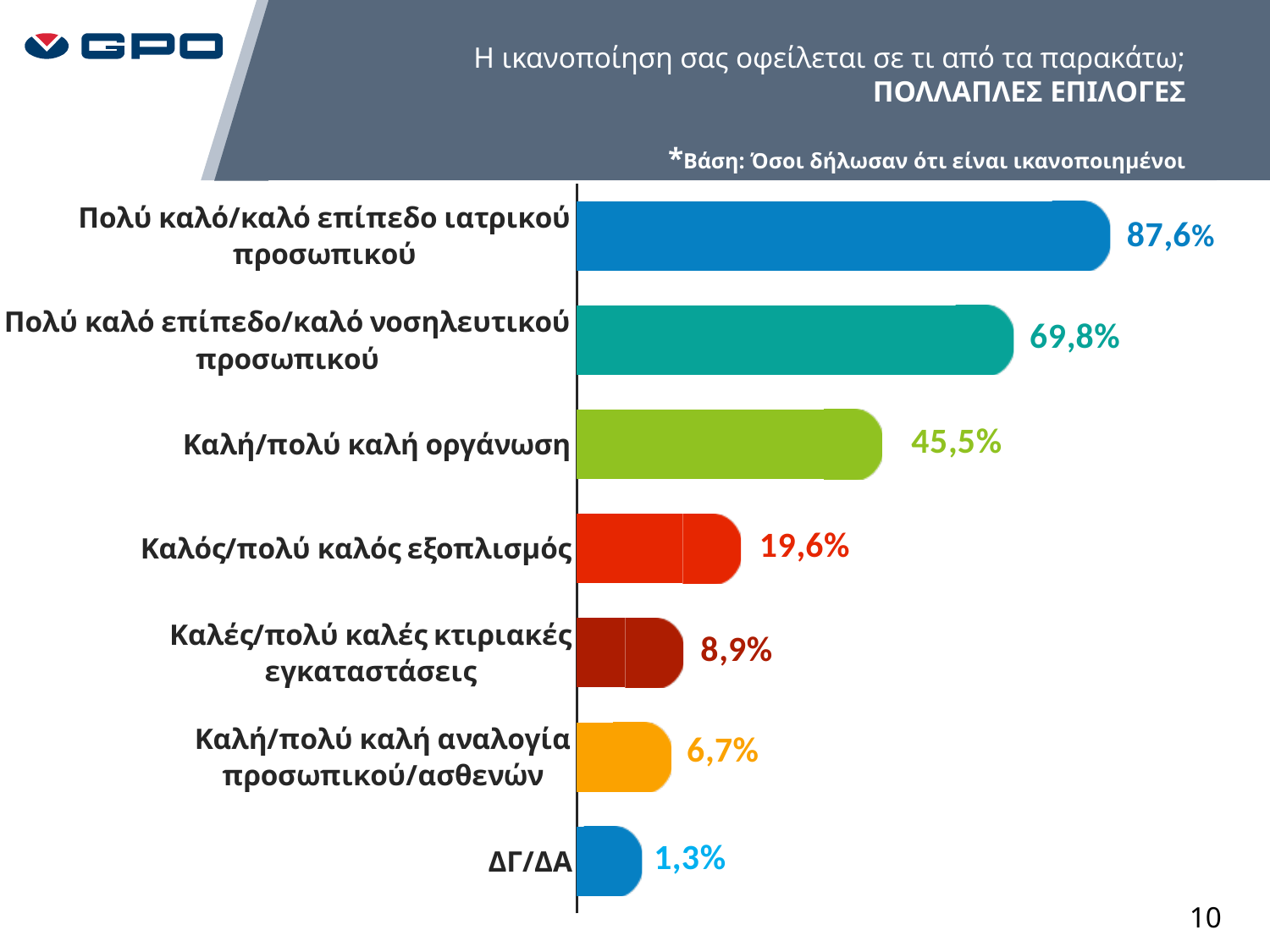
What is the value for 'Πολύ καλό/καλό επίπεδο ιατρικού προσωπικού'? 87,6% Which category has the lowest value? ΔΓ/ΔΑ How many categories are shown in the chart? 7 What is the difference between the values for 'Πολύ καλό/καλό επίπεδο ιατρικού προσωπικού' and 'Πολύ καλό επίπεδο/καλό νοσηλευτικού προσωπικού'? 17,8% Which is larger: the value for 'Καλές/πολύ καλές κτιριακές εγκαταστάσεις' or 'Καλή/πολύ καλή αναλογία προσωπικού/ασθενών'? Καλές/πολύ καλές κτιριακές εγκαταστάσεις What is the value for 'Καλή/πολύ καλή οργάνωση'? 45,5% What is the value for 'Καλός/πολύ καλός εξοπλισμός'? 19,6% What is the difference between the values for 'Καλός/πολύ καλός εξοπλισμός' and 'Καλές/πολύ καλές κτιριακές εγκαταστάσεις'? 10,7% What is the value for 'ΔΓ/ΔΑ'? 1,3% What kind of chart is shown on the slide? Bar chart Which category has the highest value? Πολύ καλό/καλό επίπεδο ιατρικού προσωπικού What colour is the bar for 'Καλή/πολύ καλή αναλογία προσωπικού/ασθενών'? Orange